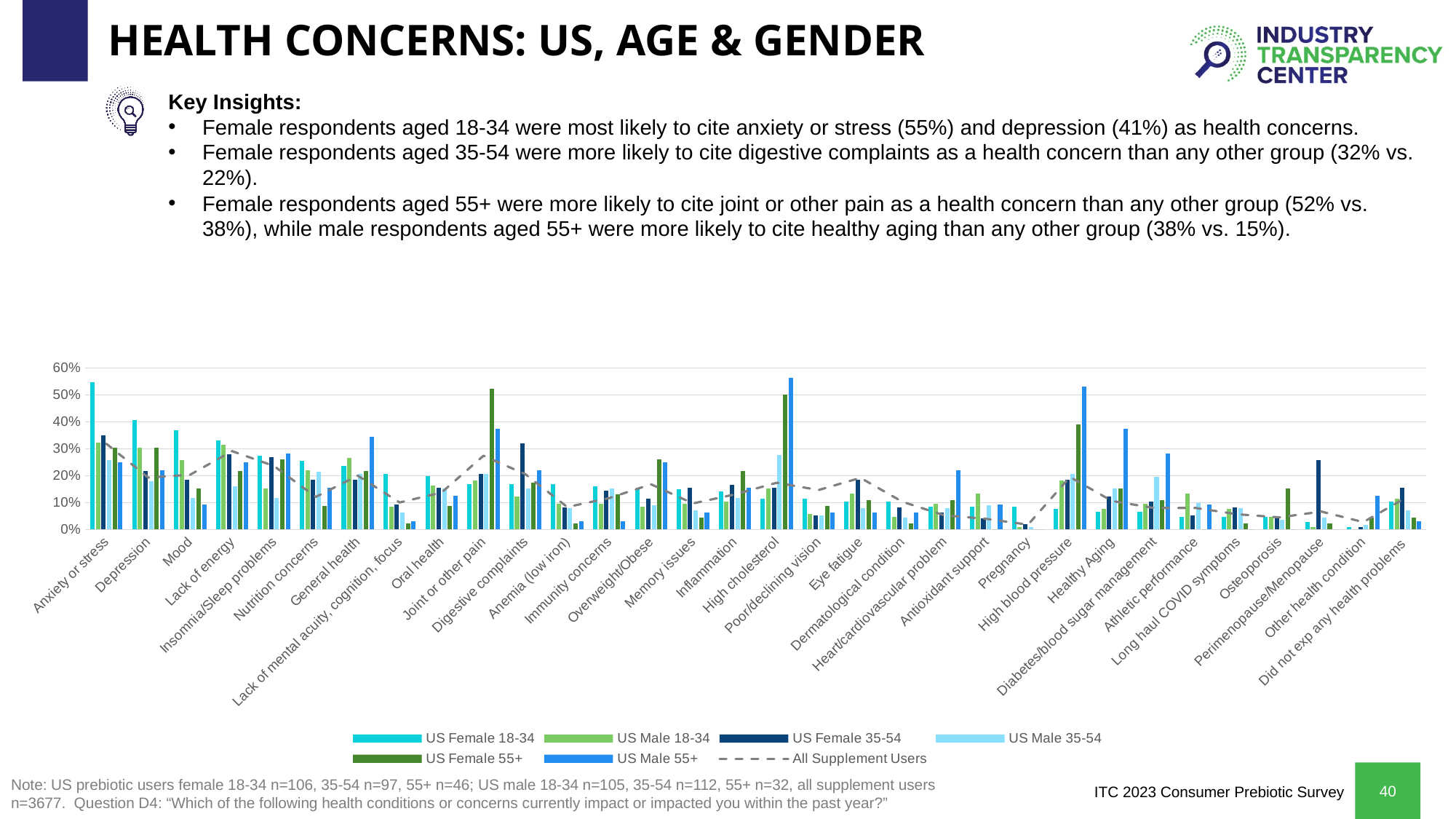
Which series in the legend is drawn as a dashed line rather than bars? All Supplement Users Is the value for US Female 55+ for Healthy Aging greater or less than 30%? less Is the value for US Male 55+ for High cholesterol greater or less than 50%? greater For High cholesterol, which is larger: US Male 55+ or US Female 18-34? US Male 55+ Is the value for US Female 18-34 for Anxiety or stress greater or less than 50%? greater How many health concern categories are shown along the x axis? 32 How many series does the chart legend list? 7 Which health concern has the highest value for US Female 18-34? Anxiety or stress For Anxiety or stress, which is larger: US Female 18-34 or US Male 18-34? US Female 18-34 What kind of chart is shown on the slide? bar and line chart